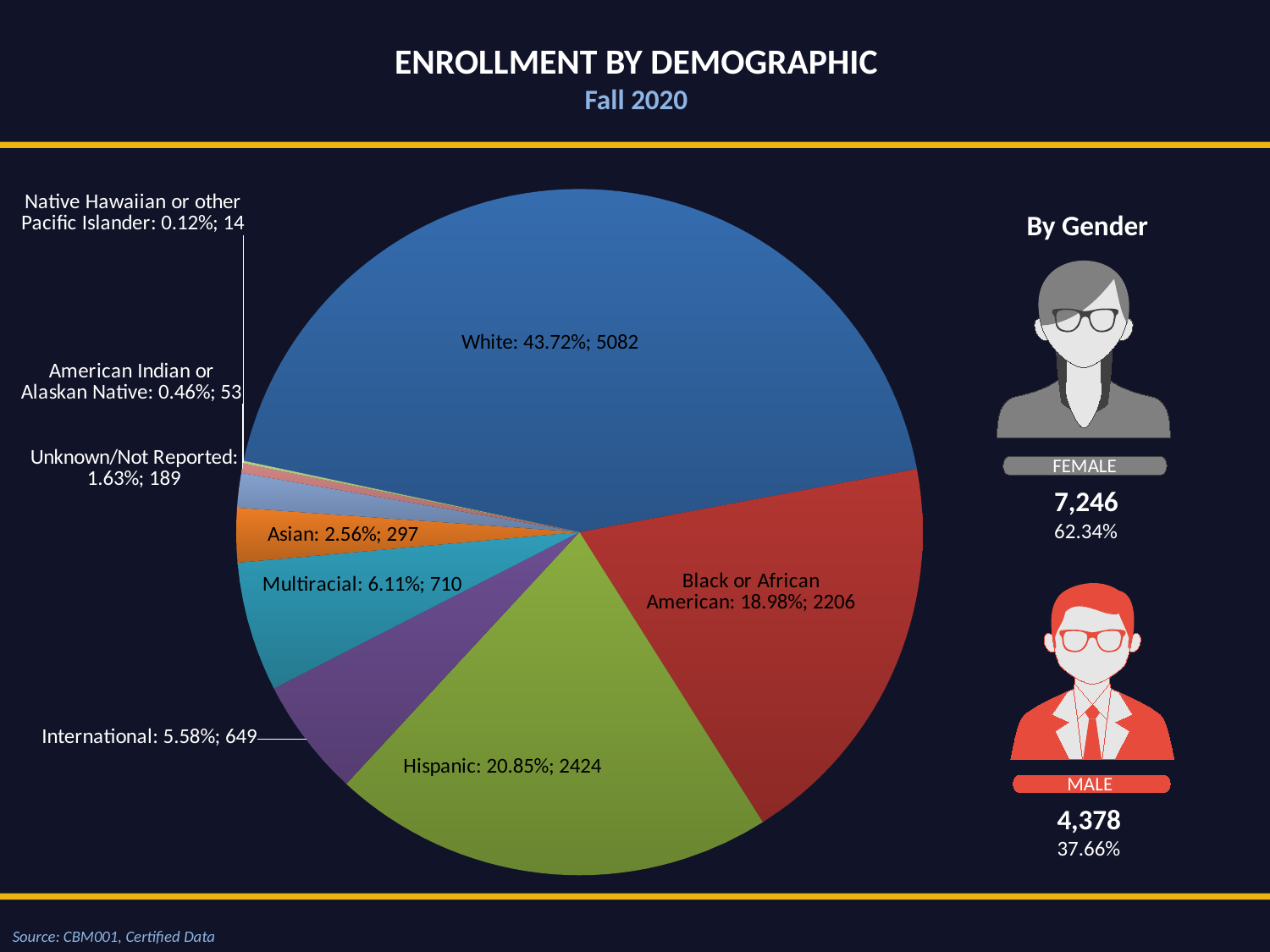
Which category has the smallest share of the pie chart? Native Hawaiian or other Pacific Islander Which has a larger enrollment count, Multiracial or International? Multiracial What is the title of the chart on the slide? ENROLLMENT BY DEMOGRAPHIC What kind of chart is shown on the slide? pie chart What is the difference in enrollment count between Hispanic and Black or African American? 218 What is the enrollment count for the White category in the pie chart? 5082 What share of enrollment is Unknown/Not Reported? 1.63% How many demographic categories does the pie chart show? 9 What is the enrollment count for the Multiracial category? 710 What percentage of enrollment is Hispanic according to the pie chart? 20.85% What is the enrollment count for American Indian or Alaskan Native? 53 Which category has the largest share of the pie chart? White